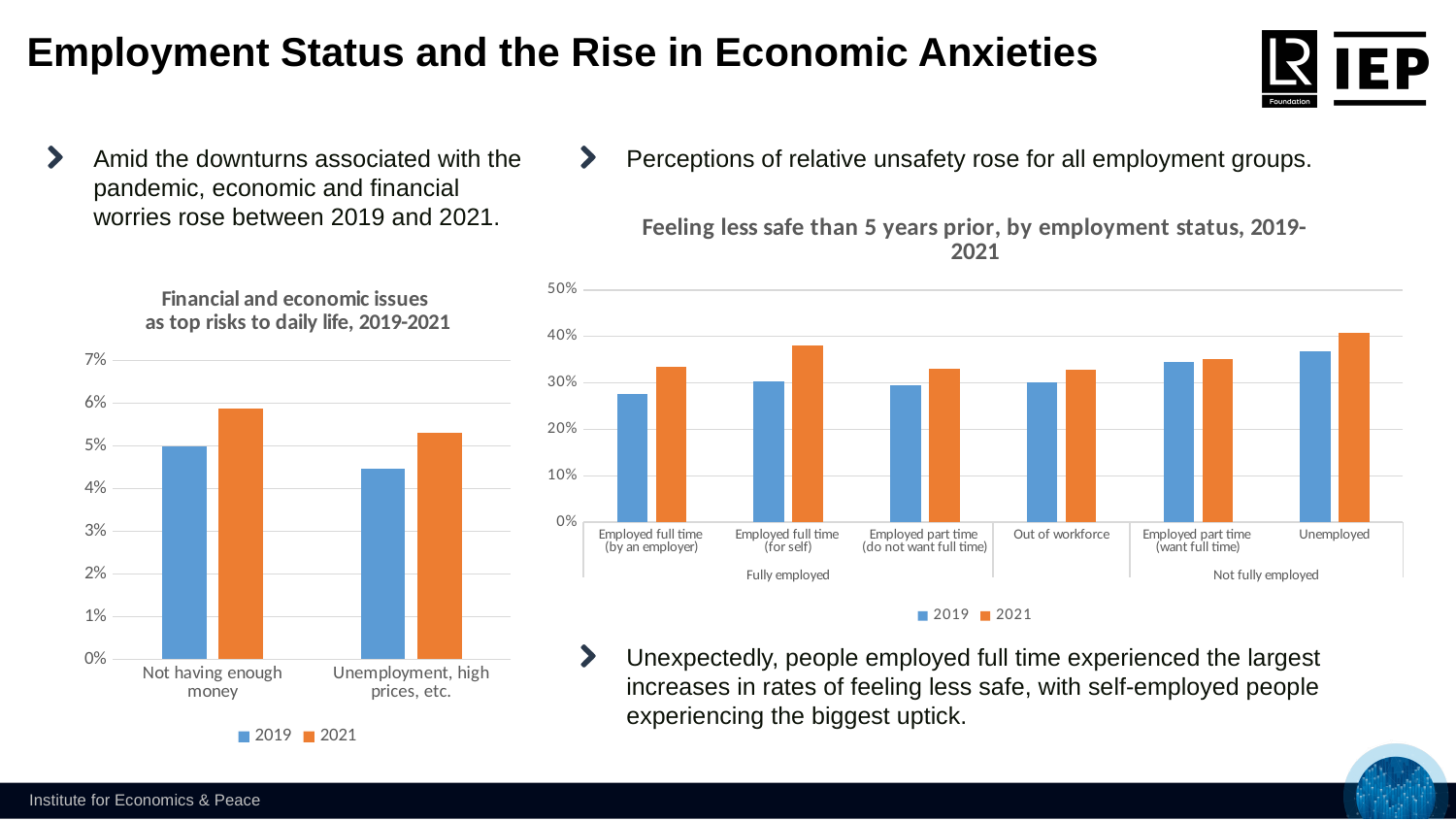
On the 'Feeling less safe than 5 years prior, by employment status, 2019-2021' chart, which employment category has the lowest 2019 value? Employed full time (by an employer) How many series does the legend list on the 'Financial and economic issues as top risks to daily life, 2019-2021' chart? 2 On the 'Feeling less safe than 5 years prior, by employment status, 2019-2021' chart, which employment category has the highest 2021 value? Unemployed On the 'Financial and economic issues as top risks to daily life, 2019-2021' chart, is the 2021 value for 'Not having enough money' greater or less than 5%? greater How many series does the legend list on the 'Feeling less safe than 5 years prior, by employment status, 2019-2021' chart? 2 How many categories are shown on the 'Financial and economic issues as top risks to daily life, 2019-2021' chart? 2 On the 'Financial and economic issues as top risks to daily life, 2019-2021' chart, which is larger for 'Not having enough money': the 2019 value or the 2021 value? 2021 On the 'Feeling less safe than 5 years prior, by employment status, 2019-2021' chart, what colour are the 2021 bars? orange On the 'Financial and economic issues as top risks to daily life, 2019-2021' chart, is the 2019 value for 'Unemployment, high prices, etc.' greater or less than 5%? less What kind of chart is the 'Financial and economic issues as top risks to daily life, 2019-2021' chart? bar chart How many employment categories are shown on the 'Feeling less safe than 5 years prior, by employment status, 2019-2021' chart? 6